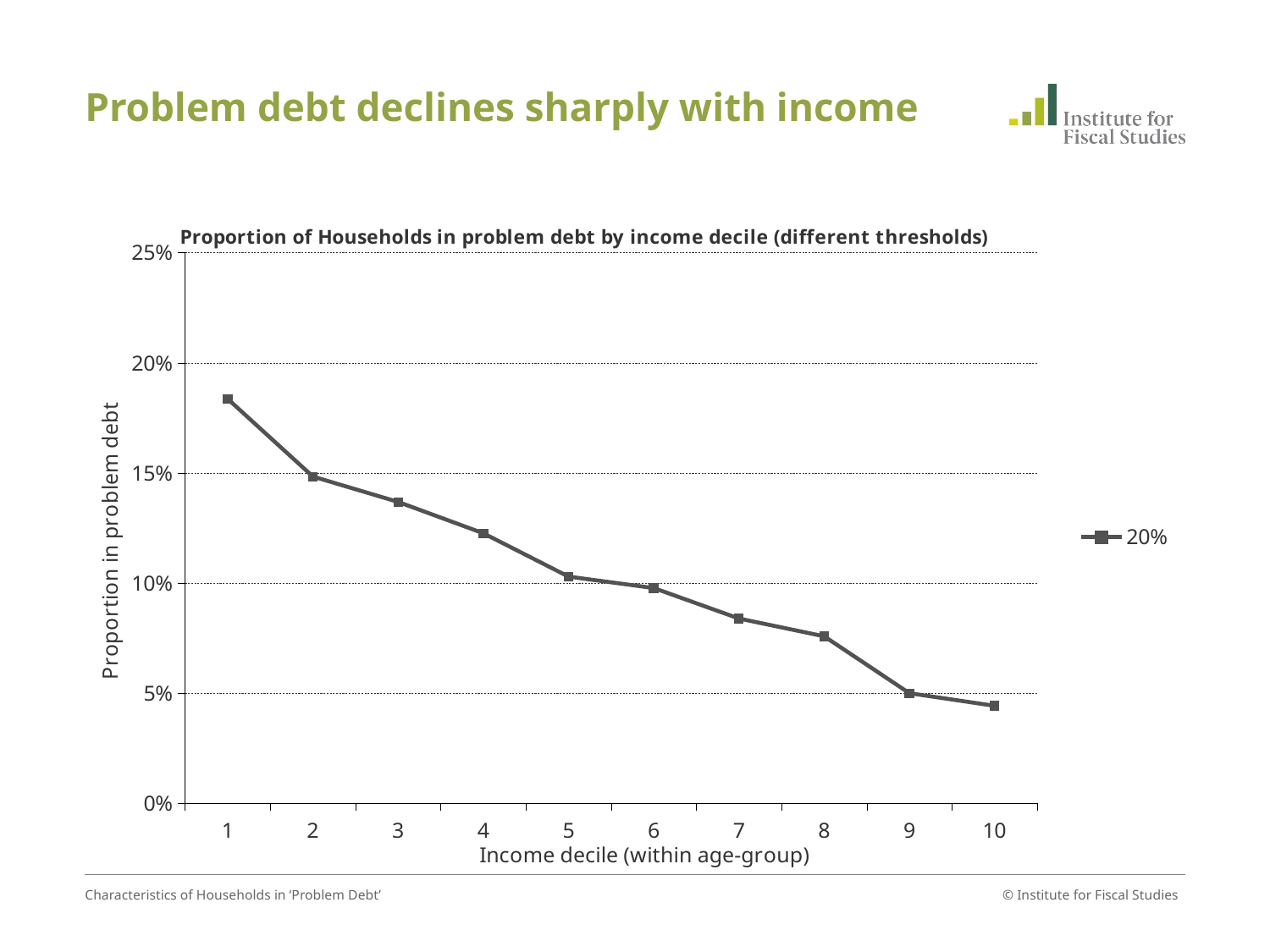
What kind of chart is shown on the slide? Line chart How many series does the legend list? 1 What is the title of the chart? Proportion of Households in problem debt by income decile (different thresholds) Is the proportion in problem debt for income decile 1 greater or less than 15%? greater How many income deciles are plotted on the x axis? 10 Which income decile has the lowest proportion in problem debt? 10 Does the proportion in problem debt rise or fall as income decile increases? Fall What is the legend entry for the plotted series? 20% Is the proportion in problem debt for income decile 3 greater or less than 10%? greater Which has a higher proportion in problem debt, income decile 2 or income decile 7? Income decile 2 Which income decile has the highest proportion in problem debt? 1 Is the proportion in problem debt for income decile 8 greater or less than 10%? less